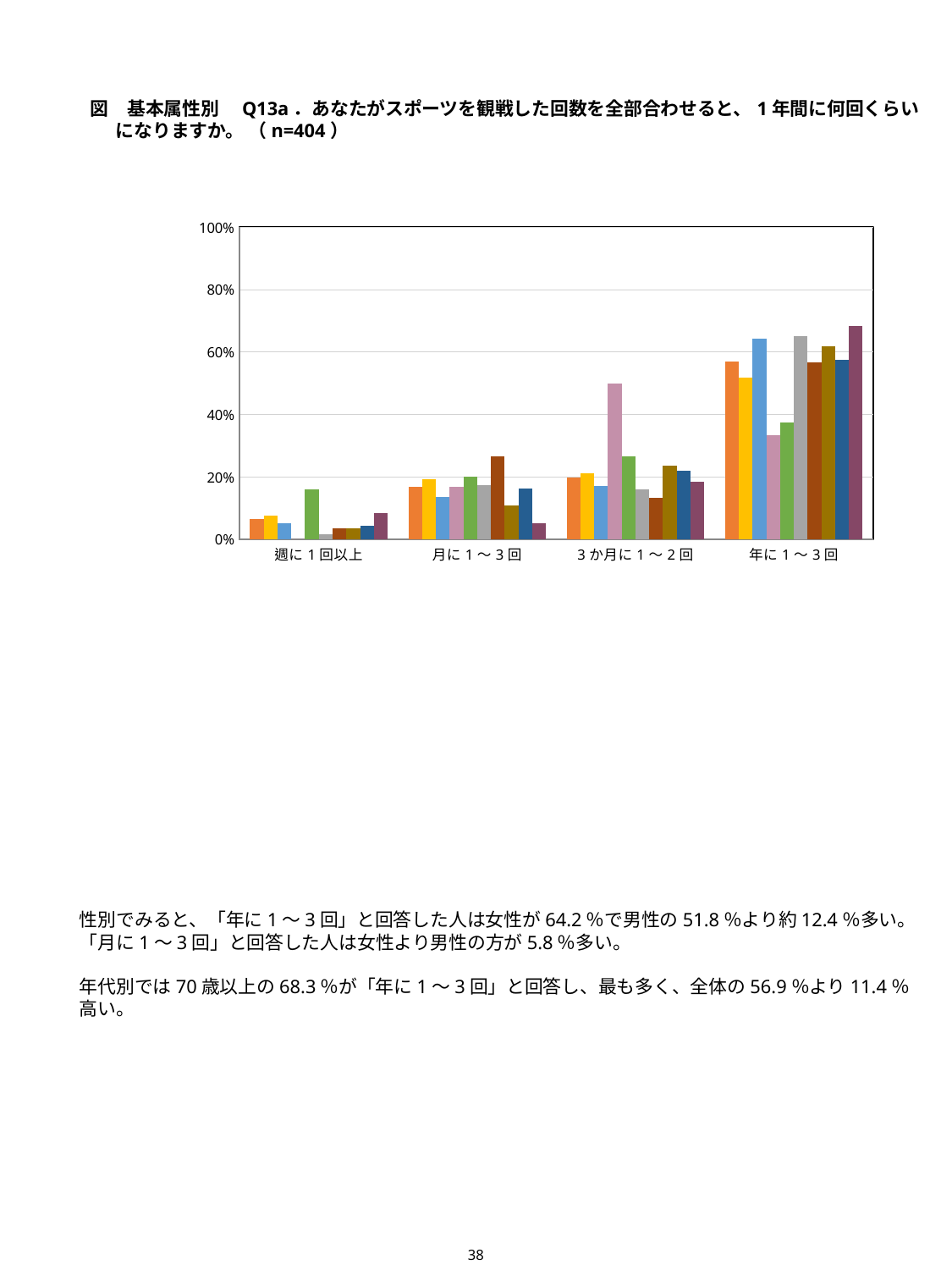
Which category has a taller maximum bar: 年に1～3回 or 3か月に1～2回? 年に1～3回 Is the tallest bar in the 月に1～3回 category greater or less than 40%? less Do the bar heights generally rise or fall moving from 週に1回以上 to 年に1～3回 along the x axis? rise What kind of chart is shown on the slide? bar chart Which category on the x axis has the lowest bars overall? 週に1回以上 What sample size (n) is stated in the chart title? n=404 Which category on the x axis has the tallest bars overall? 年に1～3回 Is the tallest bar in the 年に1～3回 category greater or less than 60%? greater Is the tallest bar in the 3か月に1～2回 category greater or less than 40%? greater How many categories are shown on the x axis of the chart? 4 What is the maximum value shown on the chart's vertical axis? 100%